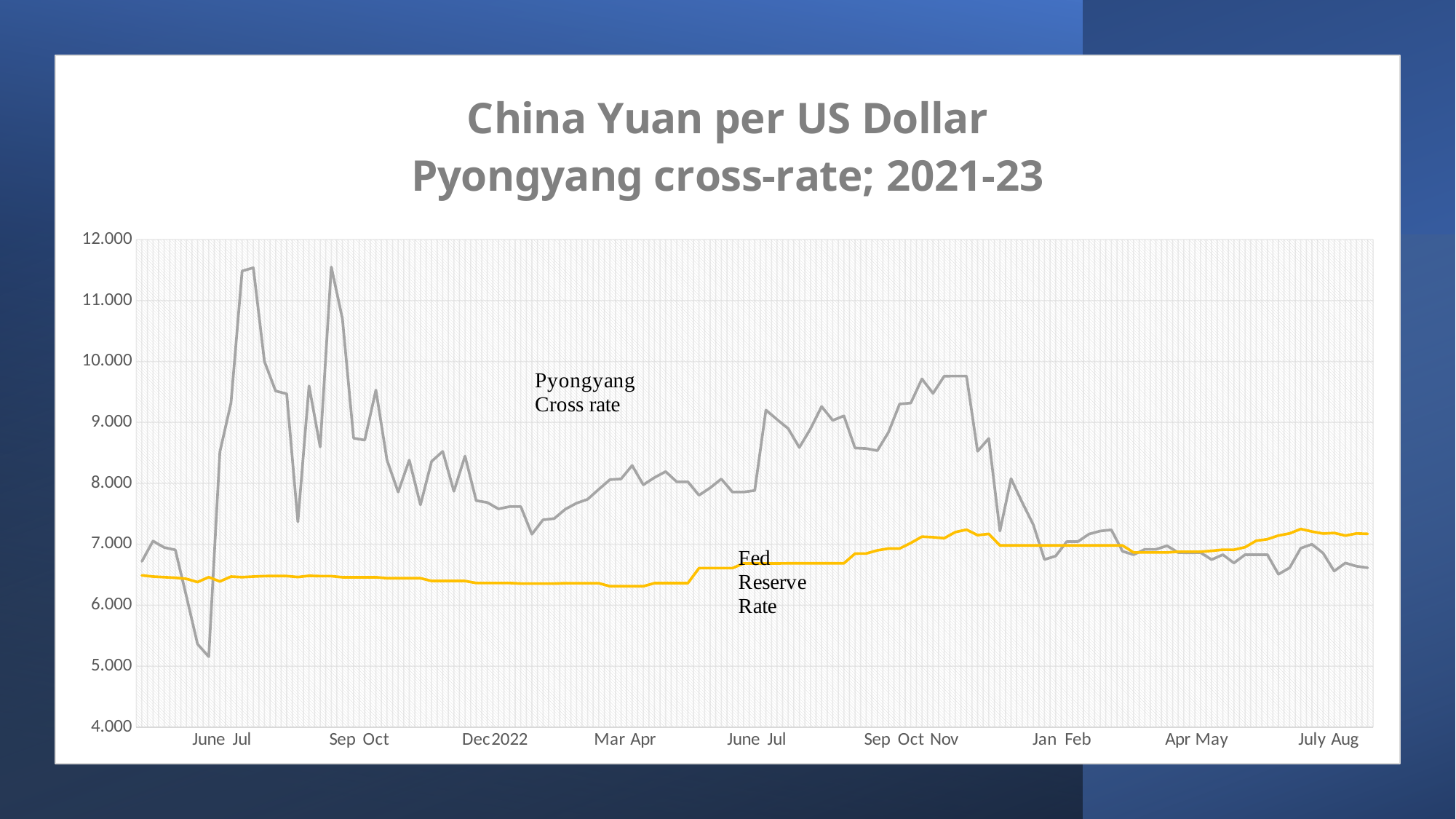
How many series are plotted on the chart? 2 Is the Pyongyang Cross rate in Nov 2022 greater or less than 9.000? greater Which series is higher in Jul 2021, the Pyongyang Cross rate or the Fed Reserve Rate? Pyongyang Cross rate Is the peak value of the Pyongyang Cross rate in Jul 2021 greater or less than 11.000? greater What kind of chart is shown on the slide? Line chart Which series is drawn in yellow? Fed Reserve Rate Does the Fed Reserve Rate rise or fall between June 2022 and Nov 2022? Rise Which series is higher in Aug 2023, the Pyongyang Cross rate or the Fed Reserve Rate? Fed Reserve Rate Is the Fed Reserve Rate in Aug 2023 greater or less than 7.000? greater What is the title of the chart? China Yuan per US Dollar Pyongyang cross-rate; 2021-23